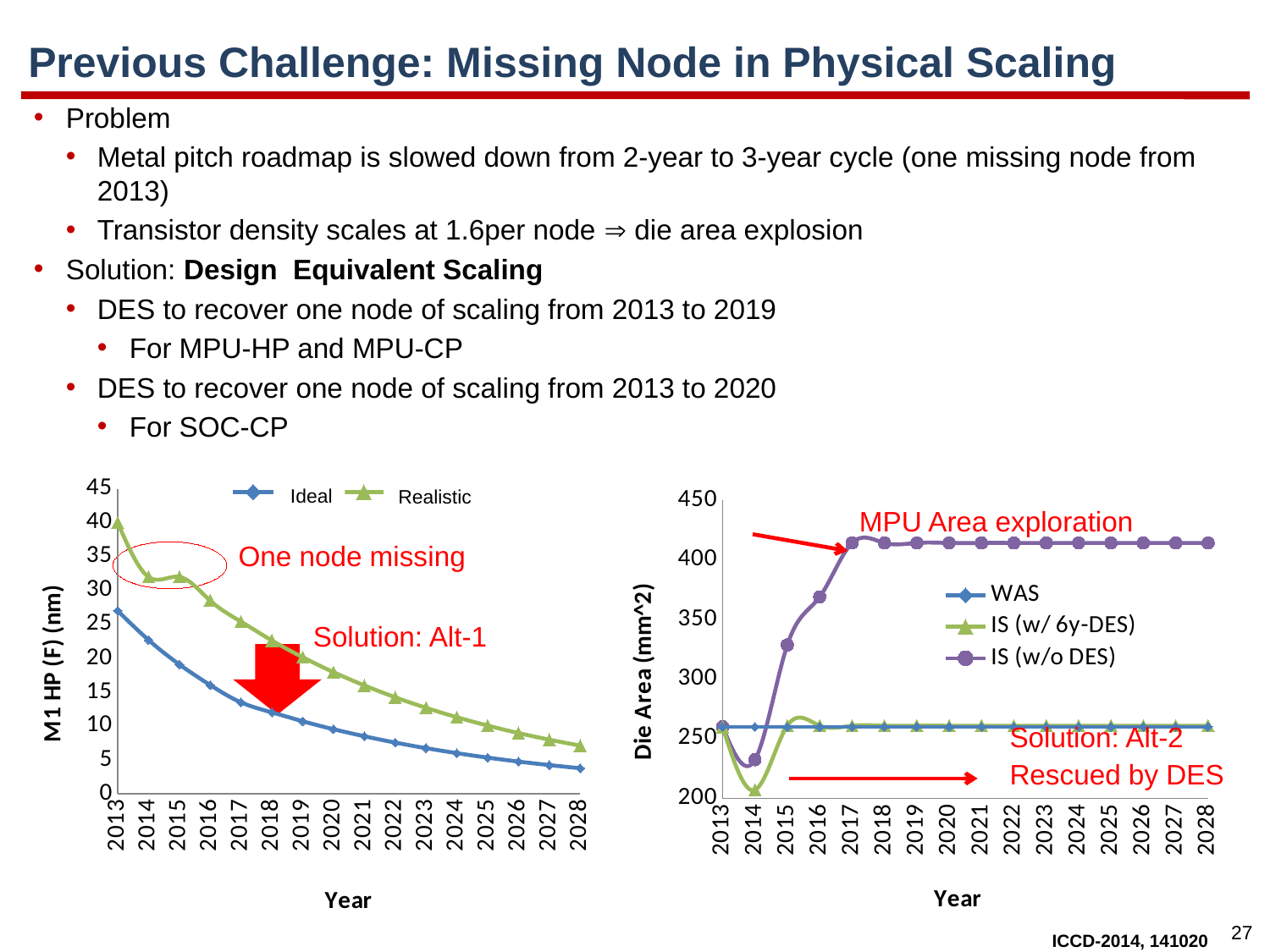
How many series does the legend of the left chart (M1 HP) list? 2 How many series does the legend of the right chart (Die Area) list? 3 In the right chart (Die Area), is the IS (w/ 6y-DES) value for 2014 greater or less than 250? less What kind of chart is the left chart (M1 HP (F) (nm) vs Year)? line chart In the right chart (Die Area), which series has the highest value in 2028? IS (w/o DES) In the left chart (M1 HP), which series has the larger value in 2020, Ideal or Realistic? Realistic In the left chart (M1 HP), is the Ideal value for 2028 greater or less than 5? less In the left chart (M1 HP), does the Ideal series rise or fall from 2013 to 2028? fall What is the y-axis title of the right chart? Die Area (mm^2) In the left chart (M1 HP), is the Realistic value for 2013 greater or less than 35? greater In the right chart (Die Area), how many years are shown on the x axis? 16